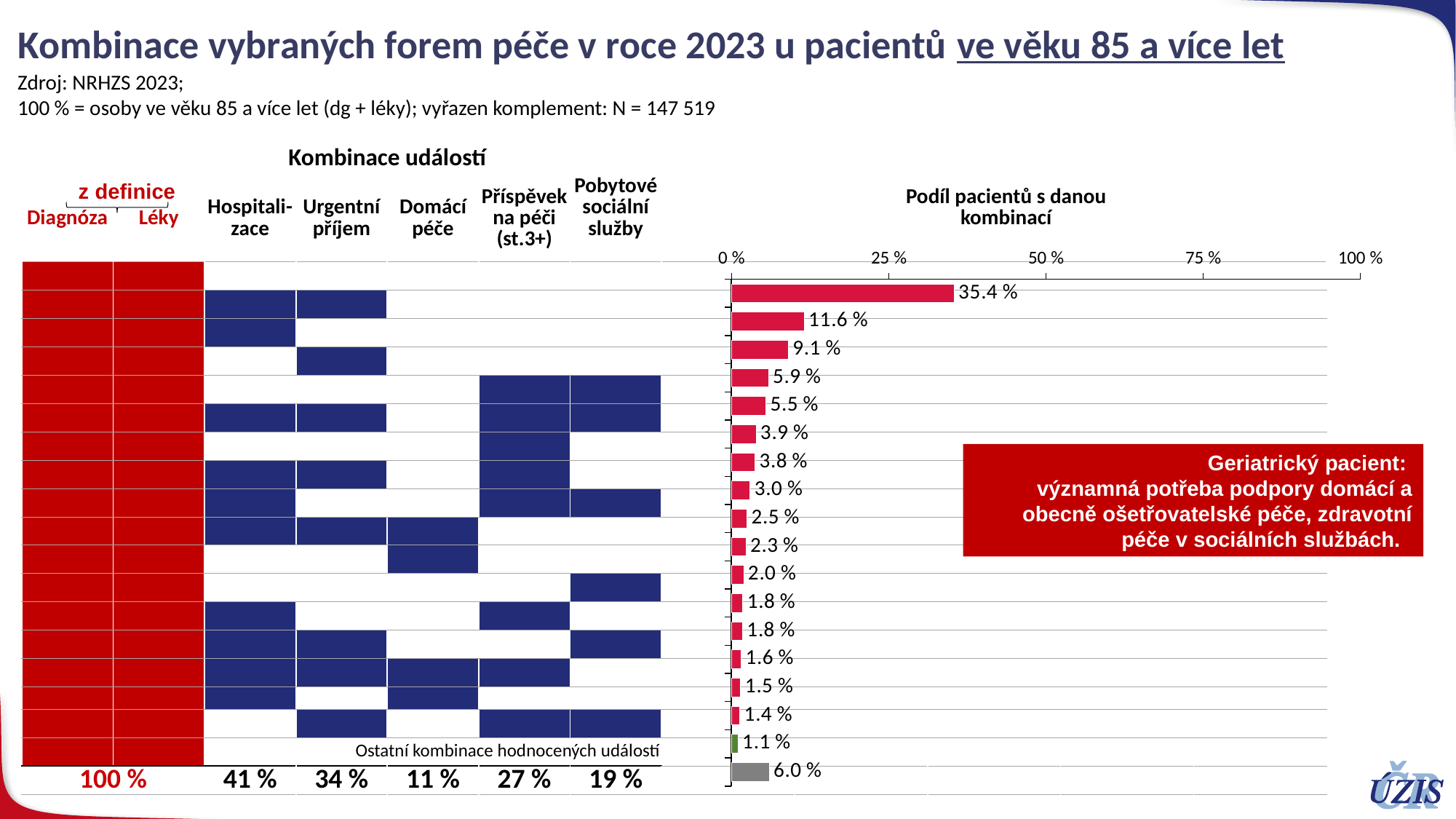
What kind of chart is 'Podíl pacientů s danou kombinací'? bar chart In the chart 'Podíl pacientů s danou kombinací', what is the difference between the top bar (35.4 %) and the second bar (11.6 %)? 23.8 % In the chart 'Podíl pacientů s danou kombinací', what is the smallest value shown? 1.1 % In the combination matrix, what percentage is shown at the bottom of the 'Hospitalizace' column? 41 % How many bars are plotted in the chart 'Podíl pacientů s danou kombinací'? 18 In the combination matrix, what percentage is shown at the bottom of the 'Domácí péče' column? 11 % In the chart 'Podíl pacientů s danou kombinací', what is the value of the longest (top) bar? 35.4 % What is the highest value shown on the x axis of the chart 'Podíl pacientů s danou kombinací'? 100 % In the chart 'Podíl pacientů s danou kombinací', what is the value of the second bar from the top? 11.6 % In the chart 'Podíl pacientů s danou kombinací', which is larger: the third bar from the top (9.1 %) or the fourth bar (5.9 %)? 9.1 % In the chart 'Podíl pacientů s danou kombinací', what is the value of the bar for 'Ostatní kombinace hodnocených událostí' (the grey bar at the bottom)? 6.0 % In the chart 'Podíl pacientů s danou kombinací', is the value of the top bar greater or less than 25 %? greater